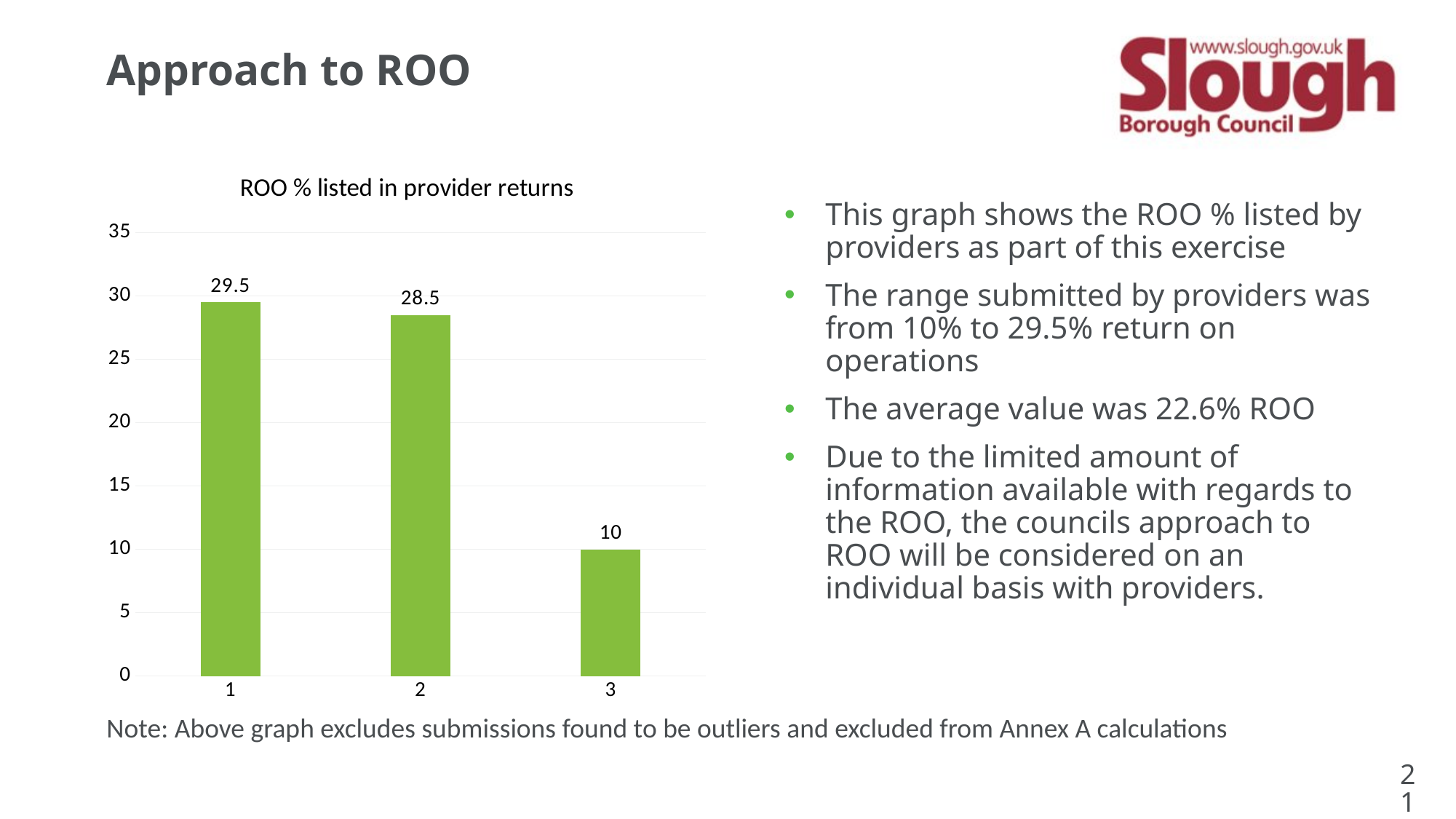
What is the value for category 1? 29.5 What is the difference between the values for category 1 and category 2? 1 Which category has the highest value? 1 What kind of chart is shown on the slide? bar chart Which category has the lowest value? 3 Which is larger, the value for category 2 or category 3? 2 What is the value for category 2? 28.5 What is the title of the chart? ROO % listed in provider returns What is the value for category 3? 10 What is the difference between the values for category 1 and category 3? 19.5 How many bars are shown in the chart? 3 Do the values rise or fall from category 1 to category 3? fall